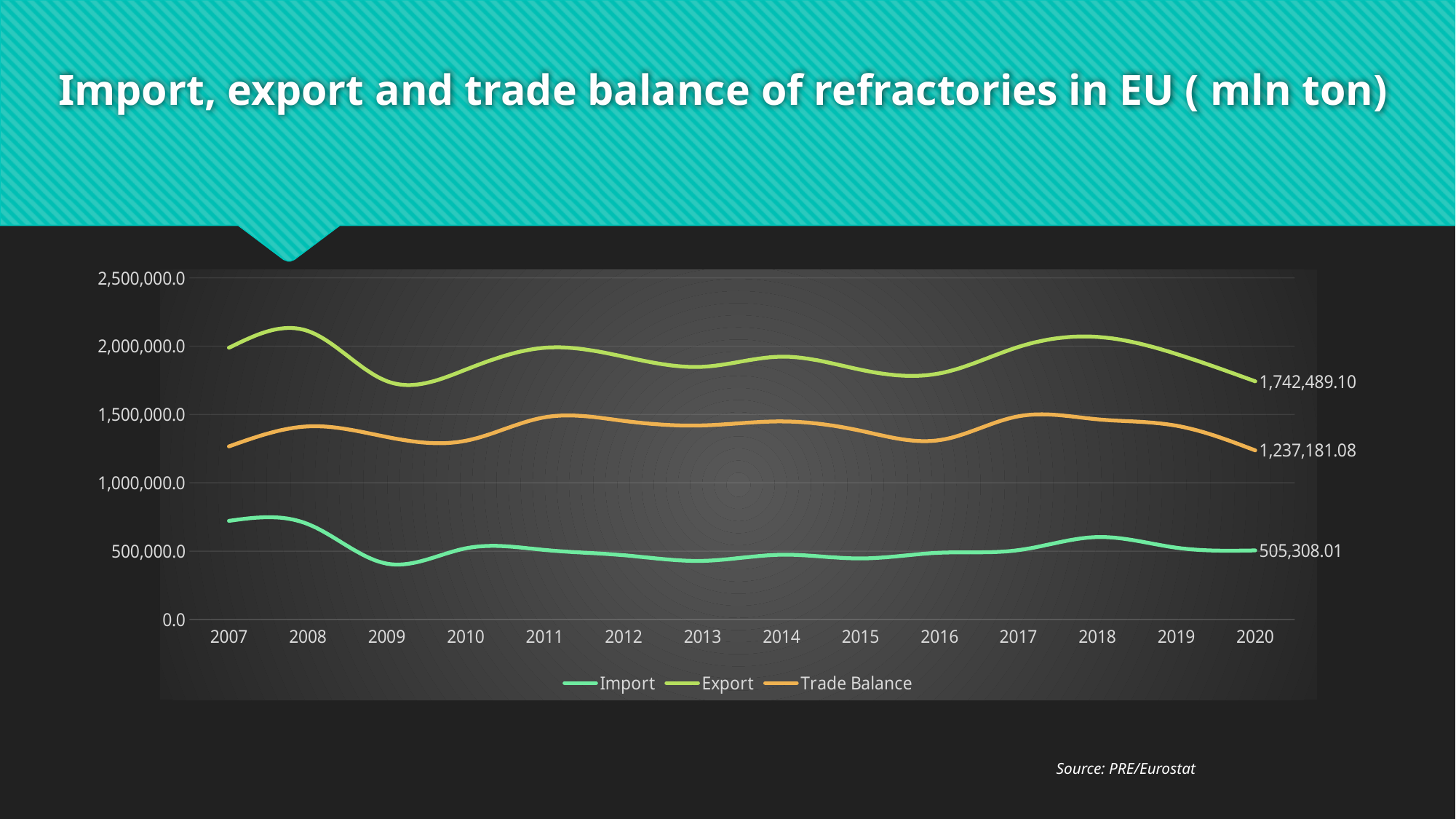
How many years are shown on the x axis? 14 How many series does the legend list? 3 What is the difference between the Export and Import values in 2020? 1,237,181.08 Is the value for Trade Balance in 2007 greater or less than 1,500,000.0? less Is the value for Import in 2007 greater or less than 500,000.0? greater Which series has the highest value in 2020? Export What is the value of Trade Balance in 2020? 1,237,181.08 What is the value of Import in 2020? 505,308.01 What is the value of Export in 2020? 1,742,489.10 Is the value for Export in 2009 greater or less than 2,000,000.0? less What kind of chart is shown on the slide? Line chart Which series has the lowest value in 2020? Import